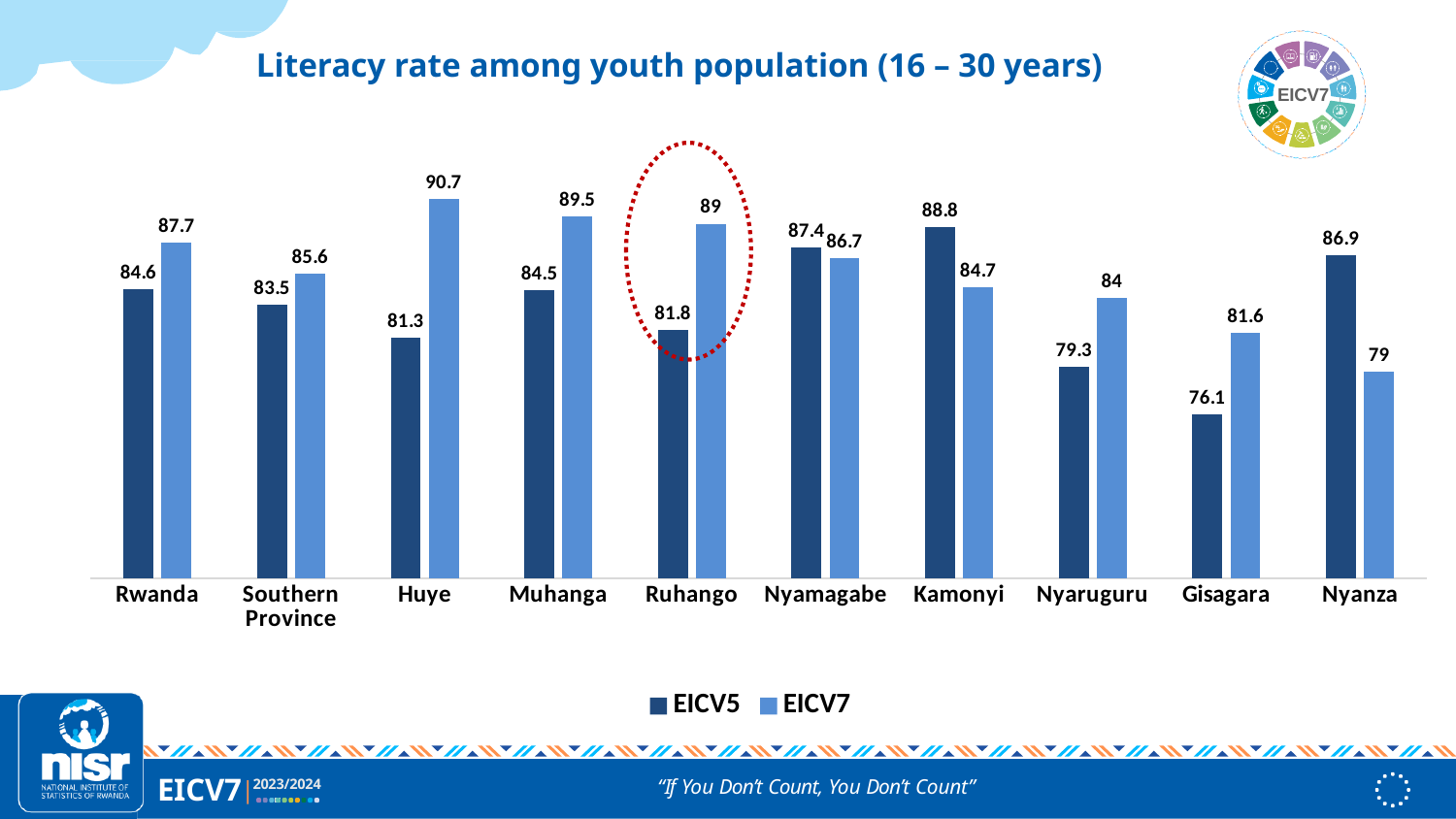
What is the EICV5 literacy rate for Gisagara? 76.1 Which category has the lowest EICV5 value? Gisagara Which category has the highest EICV7 value? Huye What kind of chart is shown on the slide? Bar chart How many series does the legend list? 2 For Nyanza, which is larger: the EICV5 value or the EICV7 value? EICV5 What is the difference between the EICV7 and EICV5 values for Ruhango? 7.2 Which category has the lowest EICV7 value? Nyanza What is the EICV7 literacy rate for Huye? 90.7 What is the difference between the EICV7 and EICV5 values for Huye? 9.4 How many categories are shown on the x axis? 10 What is the EICV7 value for Ruhango? 89